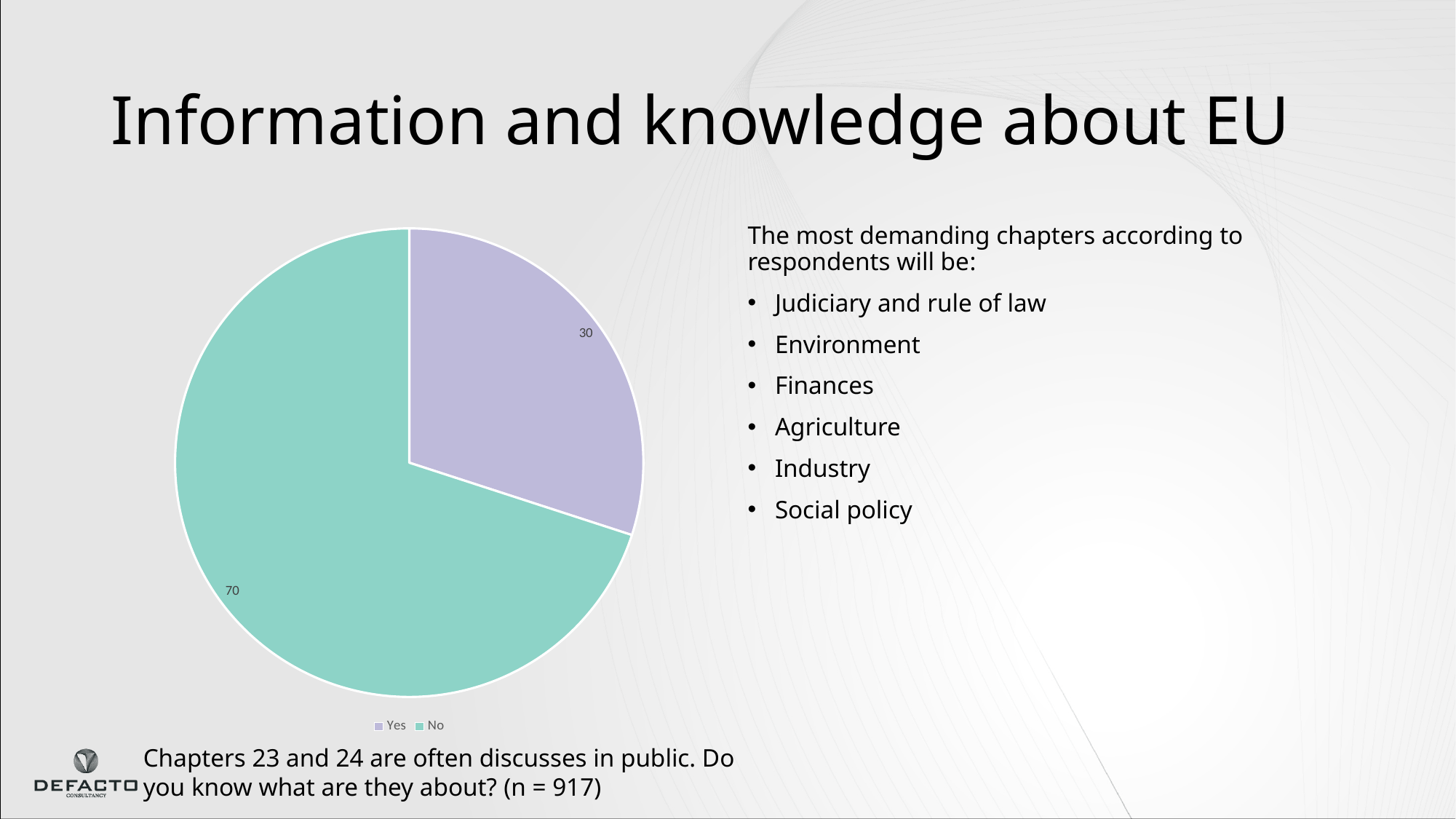
What is the sample size (n) stated in the caption below the chart? 917 What is the value for the "No" slice? 70 What is the difference between the "No" and "Yes" values? 40 Which slice is the smallest? Yes Which slice is the largest? No How many entries does the legend list? 2 What kind of chart is shown on the slide? pie chart How many slices does the pie chart have? 2 What colour is the "Yes" slice? purple What is the value for the "Yes" slice? 30 Which is larger, the "Yes" slice or the "No" slice? No What share of the pie does the "No" slice represent? 70%